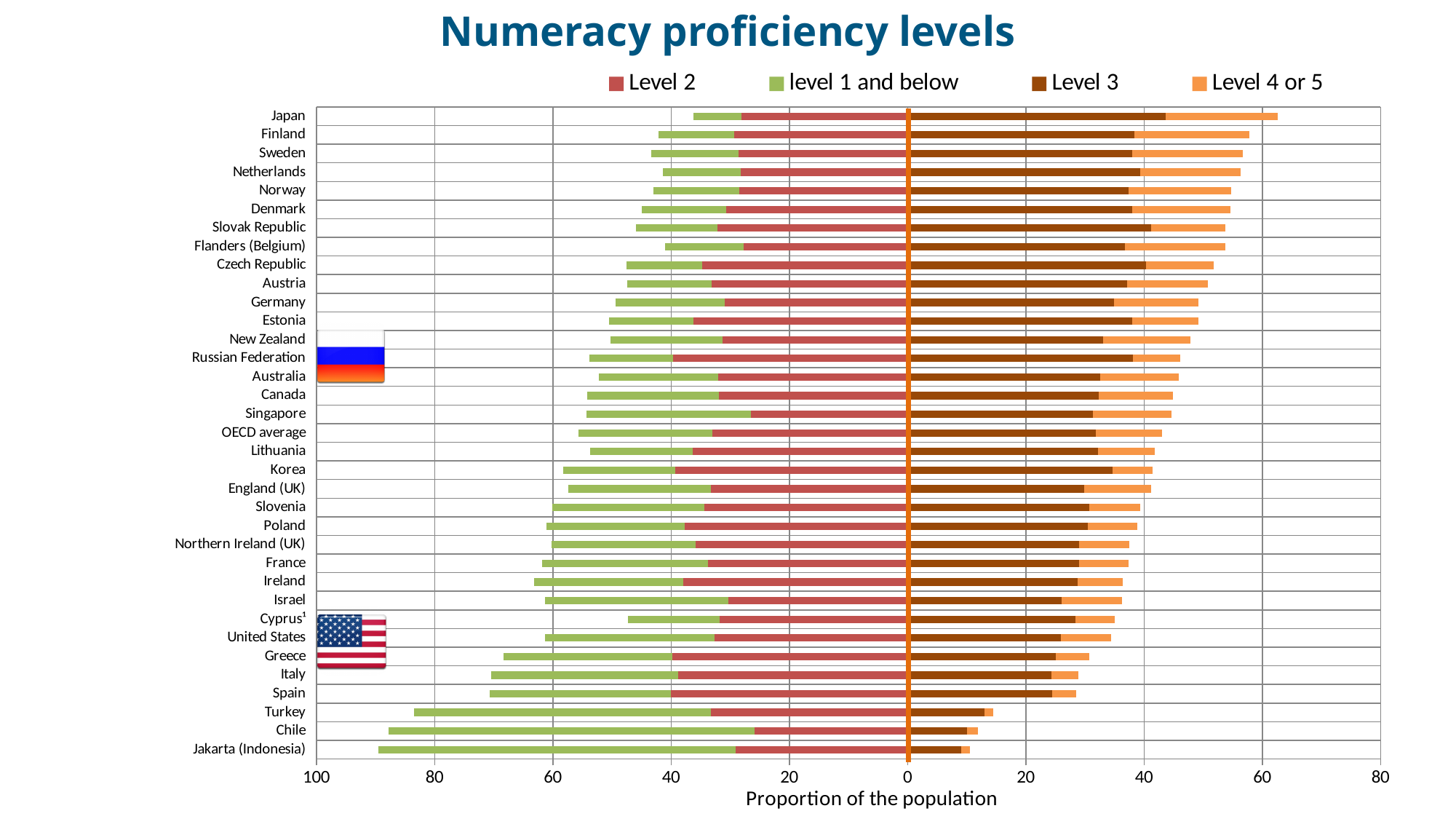
What is the title of the chart? Numeracy proficiency levels Is the combined Level 3 and Level 4 or 5 value for Japan greater or less than 60? greater Is the combined Level 3 and Level 4 or 5 value for Turkey greater or less than 20? less Which country or region has the longest bar to the left of zero (Level 2 plus level 1 and below combined)? Jakarta (Indonesia) Which has the larger combined Level 3 and Level 4 or 5 bar, Japan or Jakarta (Indonesia)? Japan What kind of chart is shown on the slide? bar chart Moving down the list from Japan to Jakarta (Indonesia), do the bars to the right of zero generally get longer or shorter? shorter How many series does the legend list? 4 How many countries or regions are listed on the vertical axis of the chart? 35 Is the combined Level 2 and level 1 and below value for Chile greater or less than 80? greater Which country has the longest bar to the right of zero (Level 3 plus Level 4 or 5 combined)? Japan What is the label of the horizontal axis? Proportion of the population